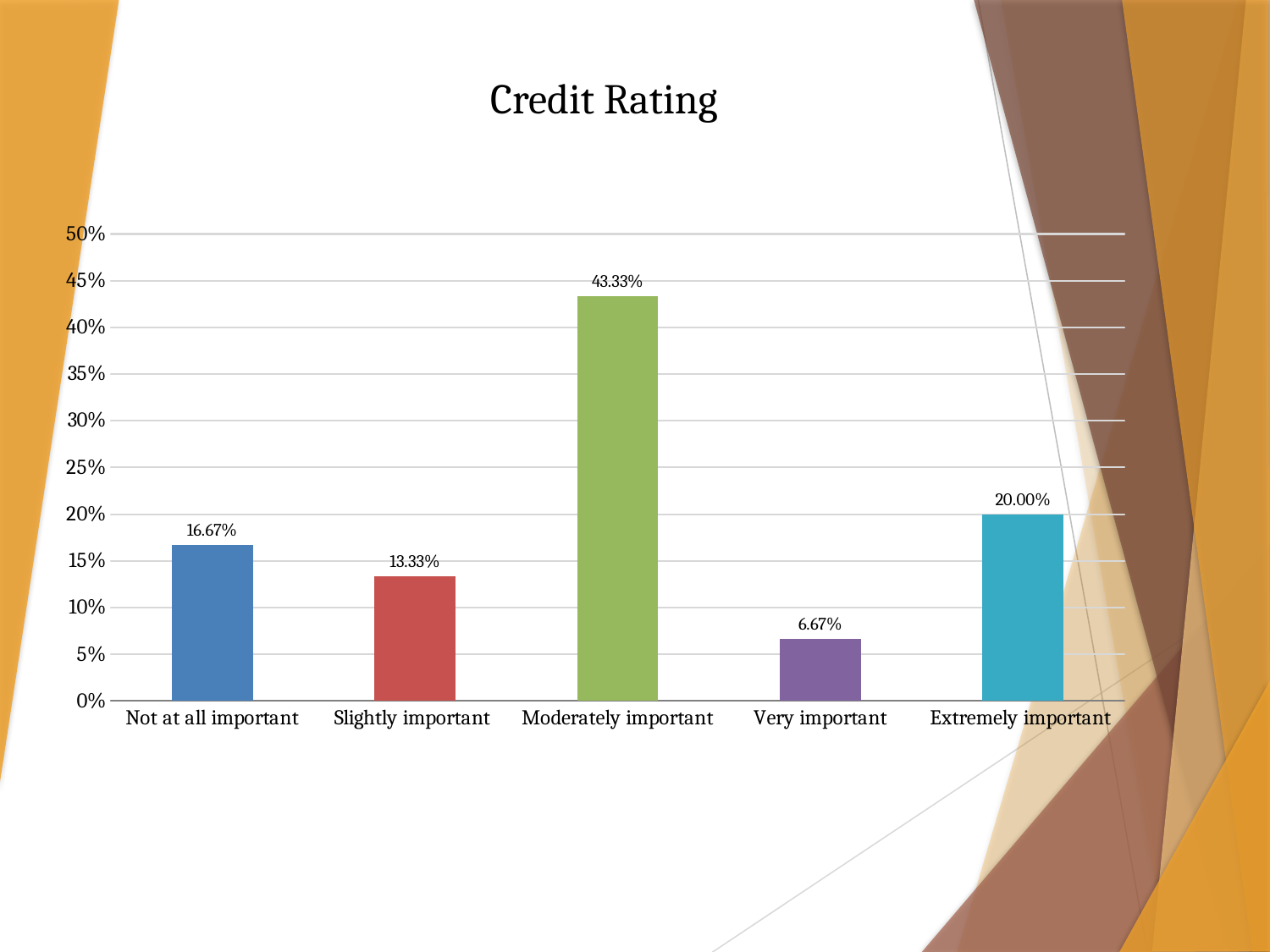
Which is larger, the value for Slightly important or the value for Extremely important? Extremely important What kind of chart is shown on the slide? Bar chart What is the value for Moderately important? 43.33% What is the difference between the values for Moderately important and Extremely important? 23.33% Is the value for Moderately important greater or less than 40%? greater How many categories are shown on the x axis? 5 Which category has the lowest value? Very important What is the value for Extremely important? 20.00% Which category has the highest value? Moderately important What is the value for Not at all important? 16.67% What is the value for Very important? 6.67% What is the difference between the values for Not at all important and Slightly important? 3.34%